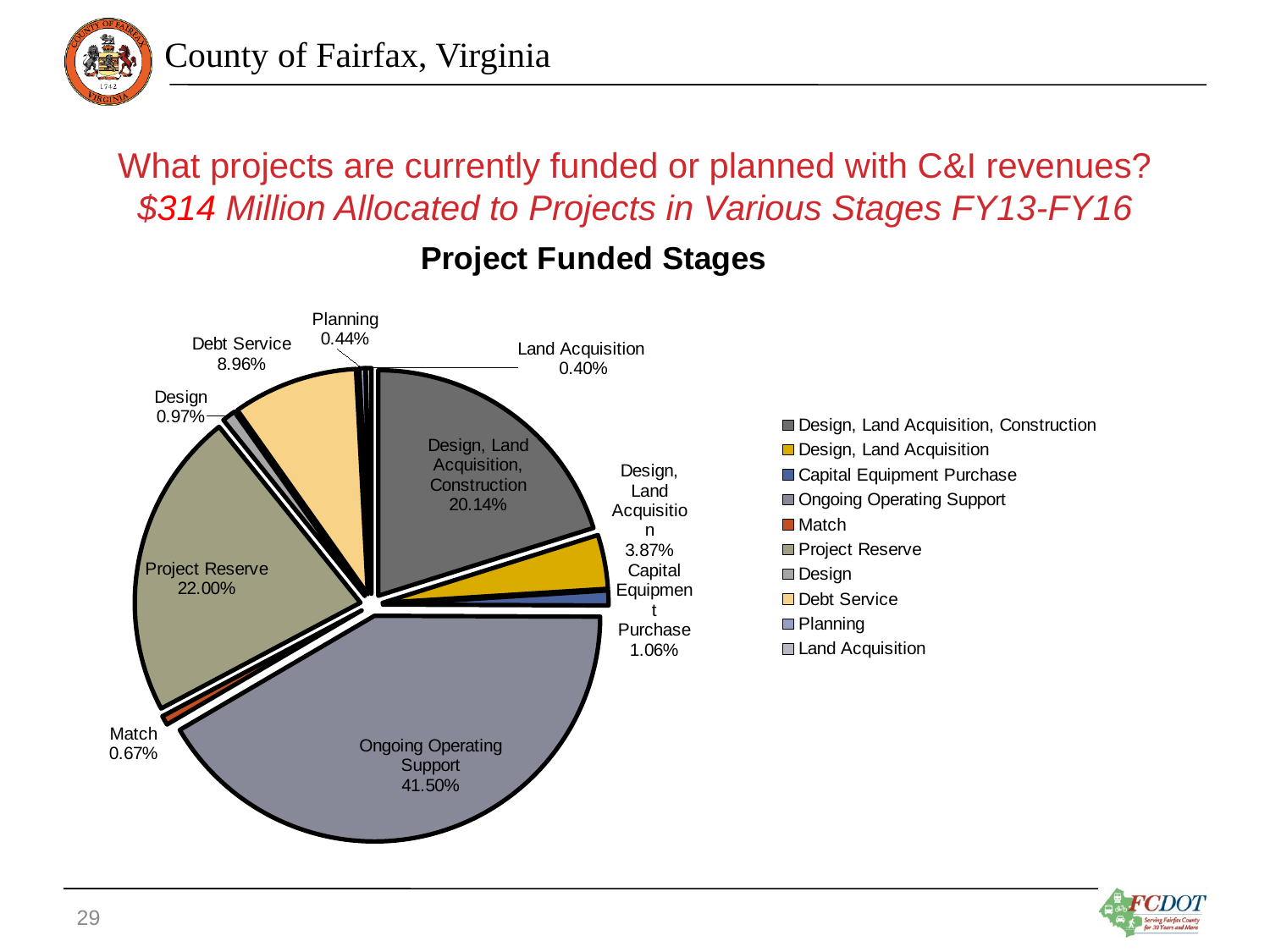
What percentage is shown for Design, Land Acquisition, Construction? 20.14% What type of chart is shown on the slide? Pie chart What percentage is shown for Project Reserve? 22.00% Which category has the largest slice of the pie? Ongoing Operating Support What is the title of the chart? Project Funded Stages What percentage is shown for Debt Service? 8.96% Which category has the smallest slice of the pie? Land Acquisition Which is larger, the share for Design, Land Acquisition or the share for Capital Equipment Purchase? Design, Land Acquisition What percentage is shown for Match? 0.67% What is the difference in percentage points between Project Reserve and Design, Land Acquisition, Construction? 1.86 How many categories does the legend list? 10 What share of the pie does Ongoing Operating Support represent? 41.50%